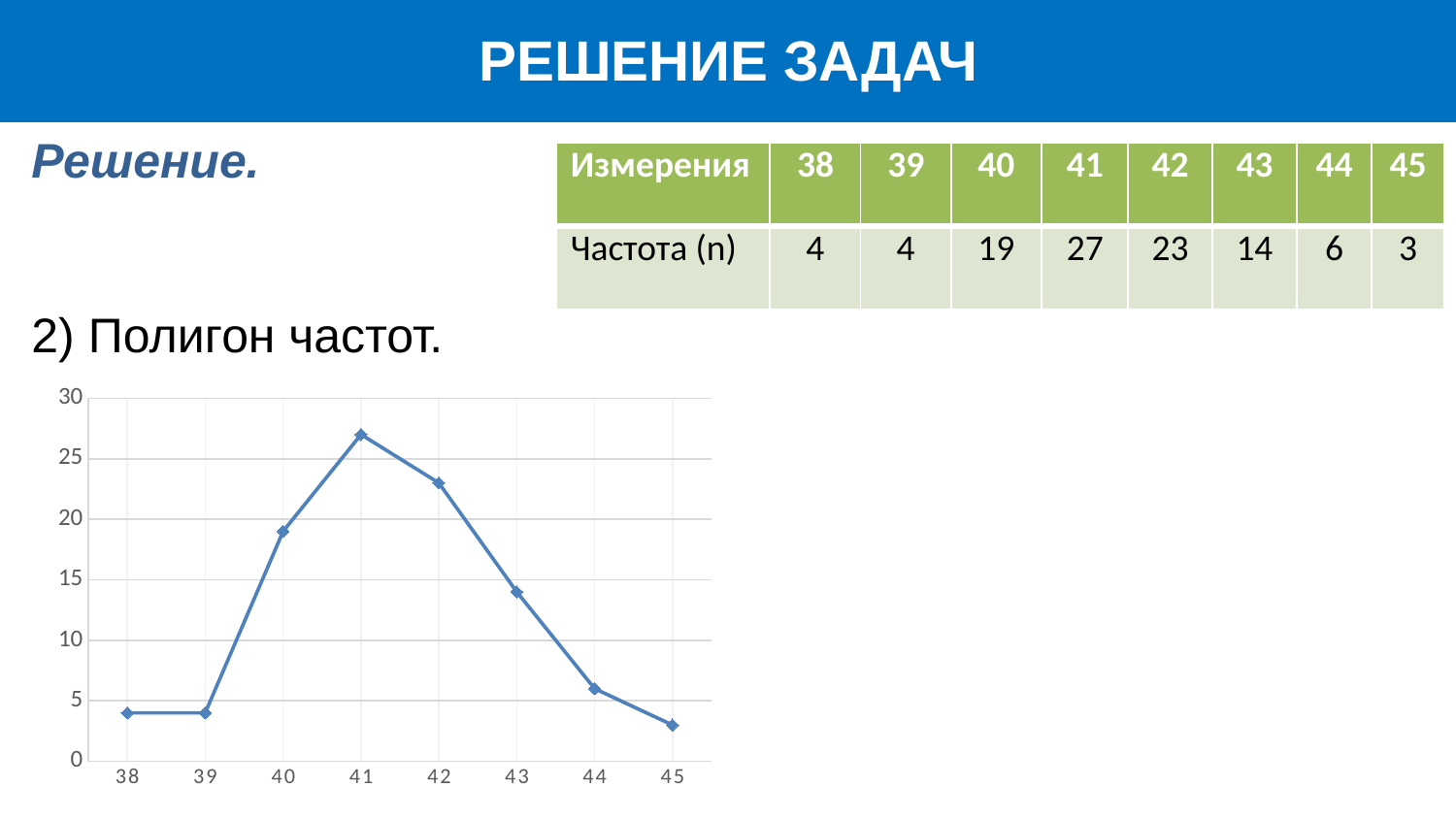
Which is larger, the value at 40 or the value at 43? 40 What is the frequency value plotted at 44? 6 What kind of chart is shown on the slide? line chart Do the values rise or fall from 41 to 45 along the x axis? fall What is the frequency value plotted at 40? 19 What is the frequency value plotted at 41? 27 At which x value does the chart reach its lowest point? 45 How many data points are plotted on the chart? 8 What is the highest tick value shown on the vertical axis? 30 What is the difference between the values at 41 and 42? 4 At which x value does the chart reach its highest point? 41 Is the value at 42 greater or less than 20? greater